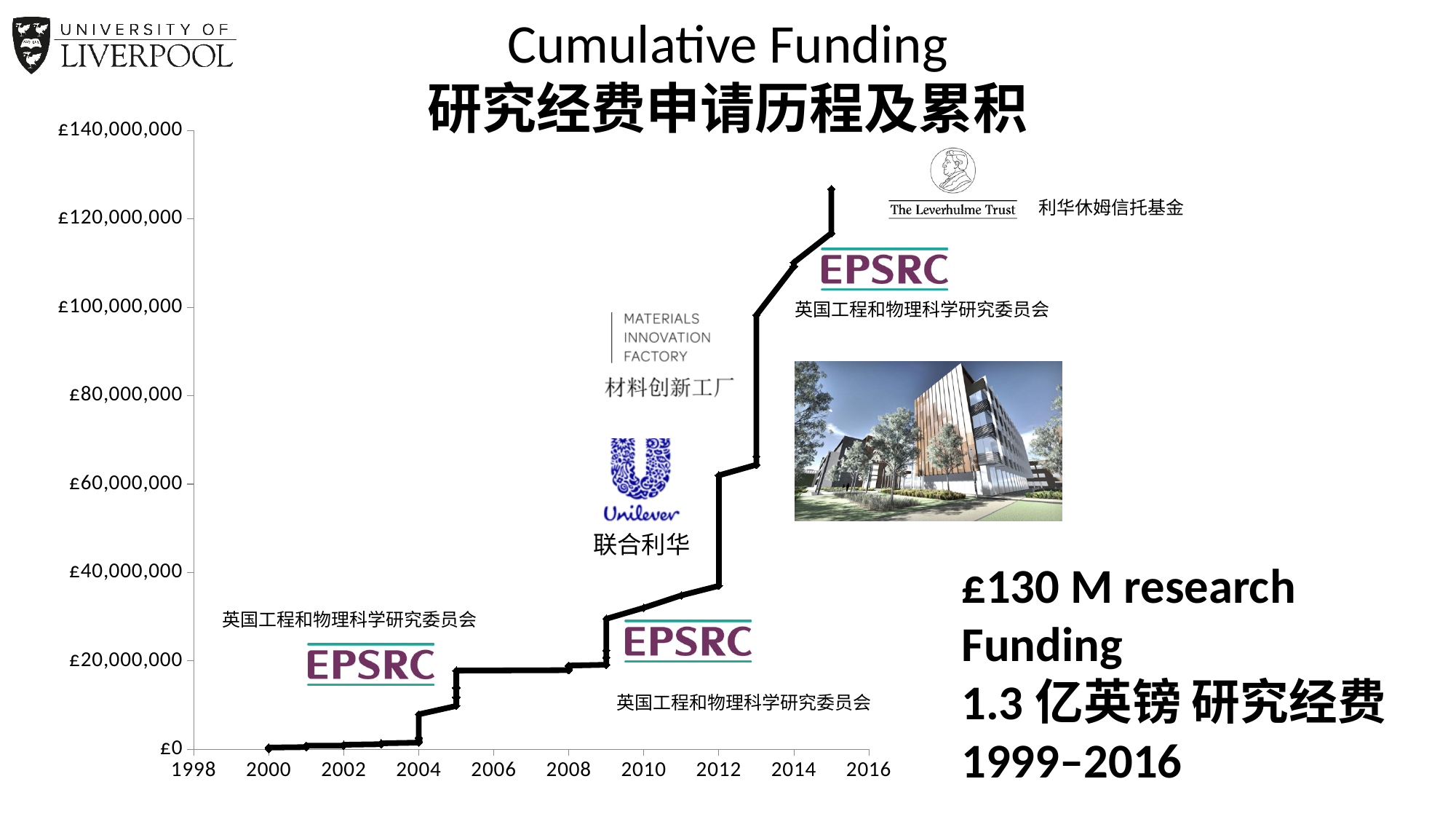
Is the cumulative funding value for 2006 greater or less than £20,000,000? less Do the values on the chart rise or fall as the years increase along the x axis? rise Is the cumulative funding value for 2010 greater or less than £40,000,000? less Is the final cumulative funding value at the end of the line (2015) greater or less than £120,000,000? greater Which year has the highest cumulative funding value on the chart? 2015 What is the highest value labelled on the y axis of the chart? £140,000,000 What is the title of the chart? Cumulative Funding What kind of chart is shown on the slide? line chart